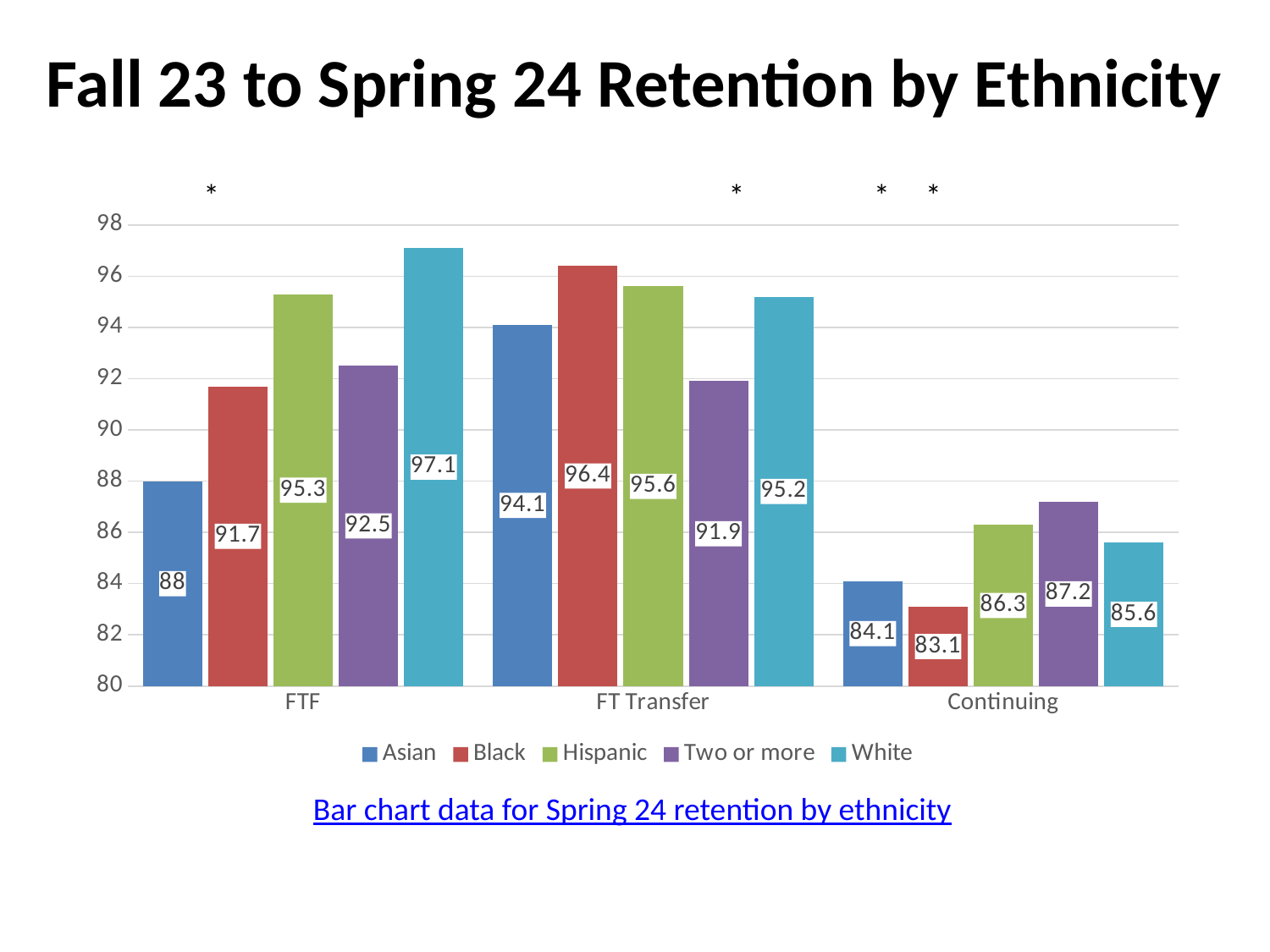
What is the retention value for Black students in the Continuing group? 83.1 What kind of chart is shown on the slide? Bar chart How many student groups are shown on the x axis? 3 What is the retention value for Asian students in the FTF group? 88 How many series does the legend list? 5 Which ethnicity has the lowest retention in the Continuing group? Black Which ethnicity has the highest retention in the FTF group? White Which ethnicity has the highest retention in the FT Transfer group? Black What is the retention value for White students in the FT Transfer group? 95.2 Which is larger: the Hispanic retention in FT Transfer or the Hispanic retention in Continuing? FT Transfer What is the difference between the White and Asian retention values in the FTF group? 9.1 Is the retention value for Two or more in the FTF group greater or less than 90? greater